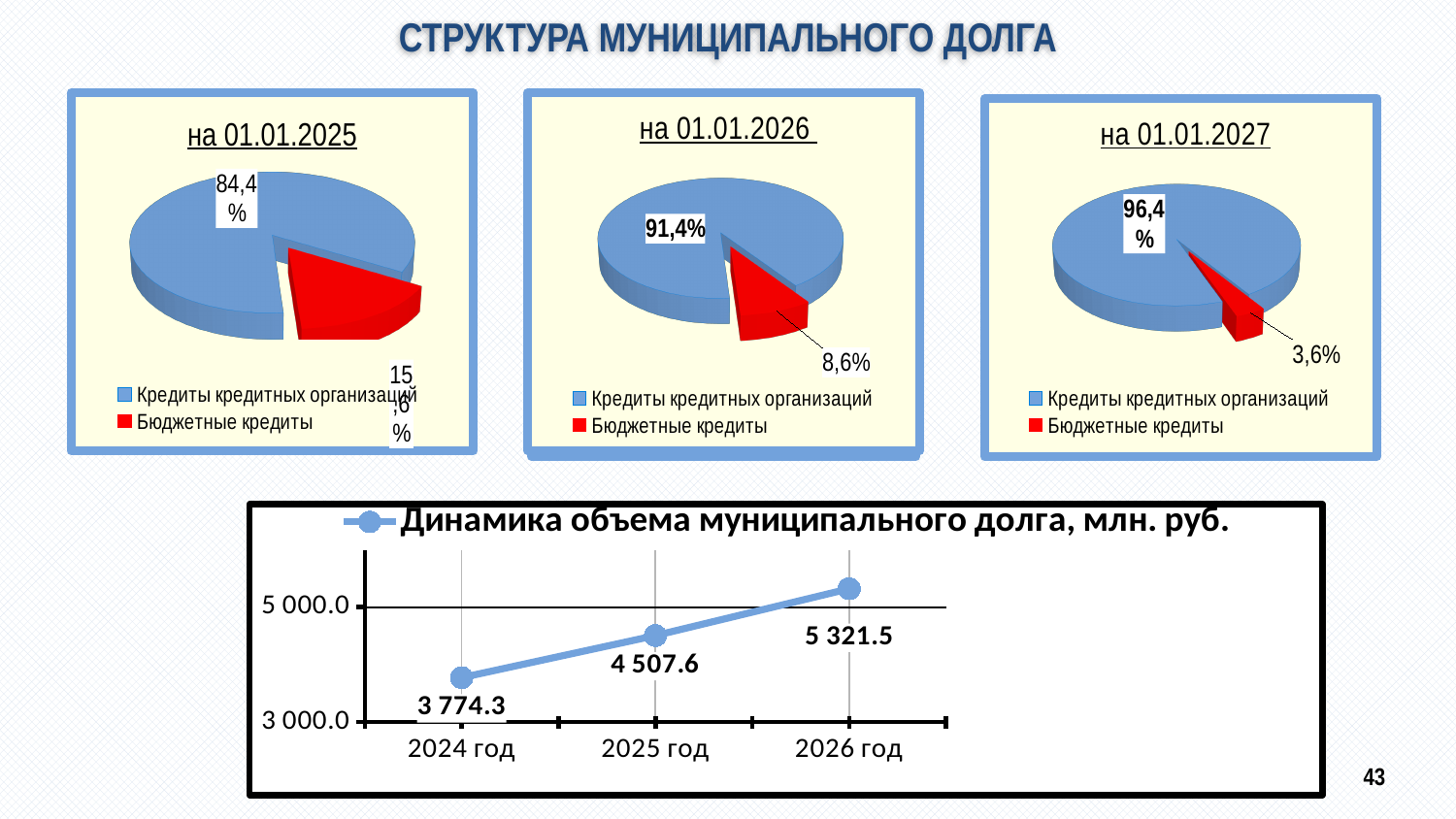
In the chart 'Динамика объема муниципального долга, млн. руб.', what is the difference between the values for 2026 год and 2024 год? 1 547.2 In the chart 'Динамика объема муниципального долга, млн. руб.', which year has the highest value? 2026 год In the pie chart 'на 01.01.2025', what share is shown for Бюджетные кредиты? 15,6% In the pie chart 'на 01.01.2027', what share is shown for Кредиты кредитных организаций? 96,4% In the pie chart 'на 01.01.2025', what share is shown for Кредиты кредитных организаций? 84,4% What kind of chart is 'Динамика объема муниципального долга, млн. руб.'? line chart In the chart 'Динамика объема муниципального долга, млн. руб.', what is the value for 2024 год? 3 774.3 In the chart 'Динамика объема муниципального долга, млн. руб.', is the value for 2026 год greater or less than 5 000.0? greater In the chart 'Динамика объема муниципального долга, млн. руб.', what is the value for 2025 год? 4 507.6 In the pie chart 'на 01.01.2027', which category has the smallest slice? Бюджетные кредиты How many categories does the legend of the pie chart 'на 01.01.2026' list? 2